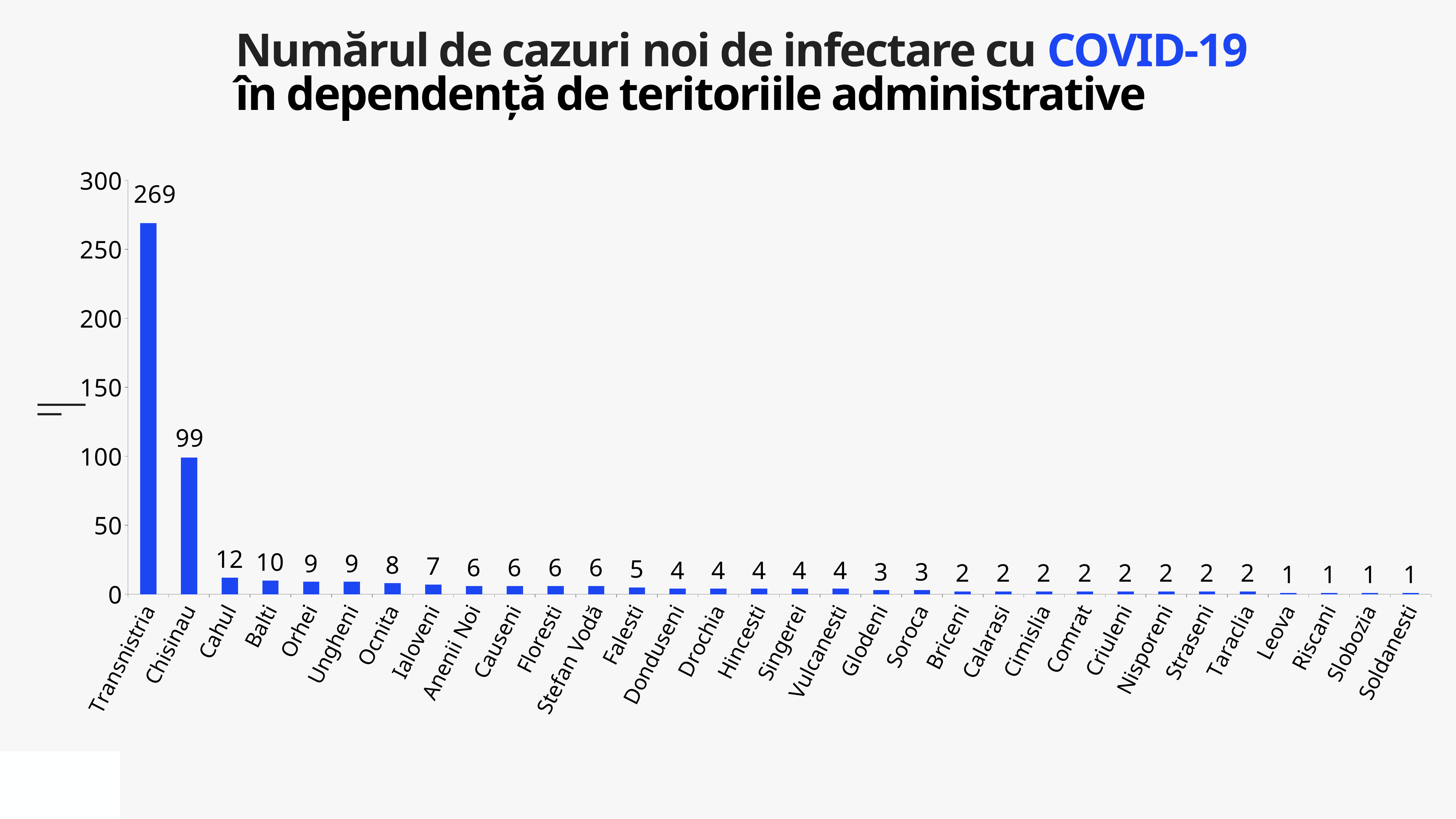
What kind of chart is shown on the slide? bar chart What is the value for Cahul? 12 How many territories are shown on the x axis? 32 What is the value for Transnistria? 269 What is the value for Chisinau? 99 Is the value for Chisinau greater or less than 100? less What is the value for Ocnita? 8 Do the values rise or fall from left to right along the x axis? fall Which territory has the highest number of new cases? Transnistria What is the difference between the values for Cahul and Balti? 2 What is the difference between the values for Transnistria and Chisinau? 170 Which is larger, the value for Ialoveni or the value for Falesti? Ialoveni